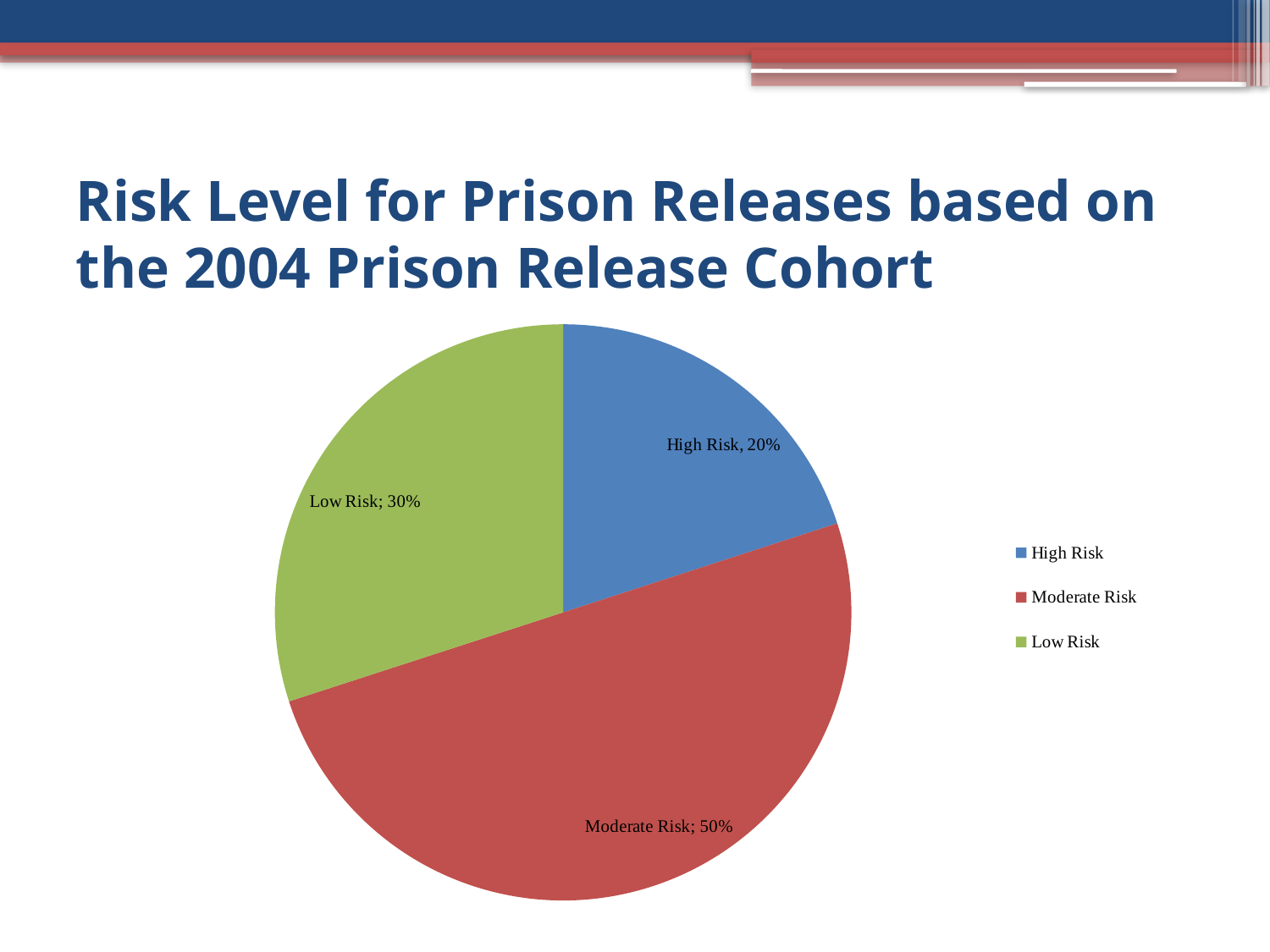
How many entries does the legend list? 3 What percentage of prison releases are labelled Low Risk? 30% What percentage of prison releases are labelled Moderate Risk? 50% What is the difference in percentage points between the Moderate Risk and High Risk slices? 30 How many slices does the pie chart have? 3 What kind of chart is shown on the slide? pie chart What percentage of prison releases are labelled High Risk? 20% Which risk level has the smallest share of the pie? High Risk What colour is the Moderate Risk slice? red Which slice is larger, Low Risk or High Risk? Low Risk Which risk level has the largest share of the pie? Moderate Risk What is the title of the slide containing the pie chart? Risk Level for Prison Releases based on the 2004 Prison Release Cohort